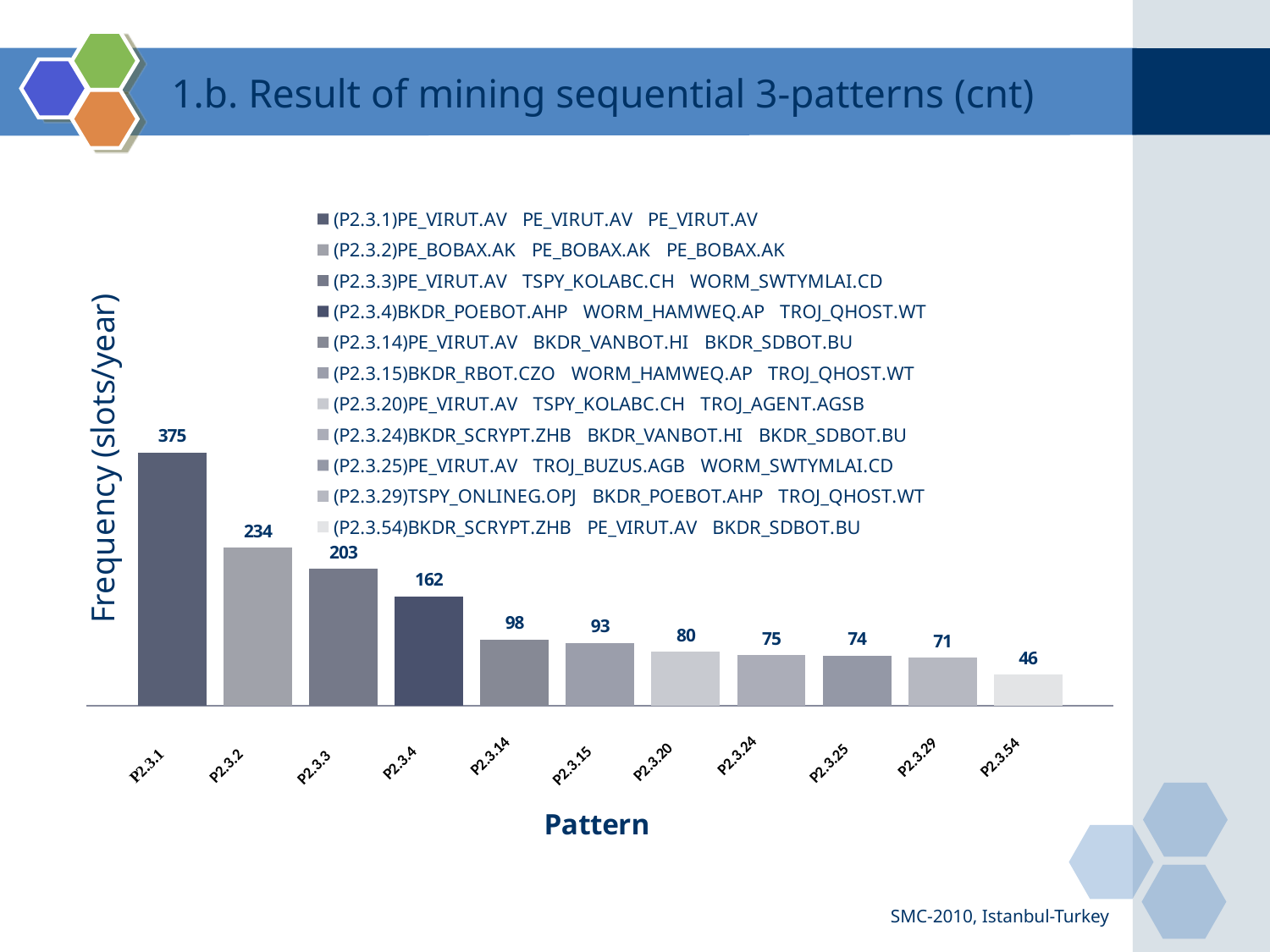
What is the frequency value for pattern P2.3.14? 98 What kind of chart is shown on the slide? Bar chart How many patterns are plotted on the x axis? 11 How many entries does the legend list? 11 Which pattern has the lowest frequency? P2.3.54 What is the difference between the frequency of P2.3.1 and P2.3.2? 141 What is the difference between the frequency of P2.3.3 and P2.3.4? 41 What is the frequency value for pattern P2.3.1? 375 What is the frequency value for pattern P2.3.29? 71 Which pattern has the highest frequency? P2.3.1 Which has a higher frequency, P2.3.15 or P2.3.20? P2.3.15 Do the frequency values rise or fall from left to right along the x axis? Fall